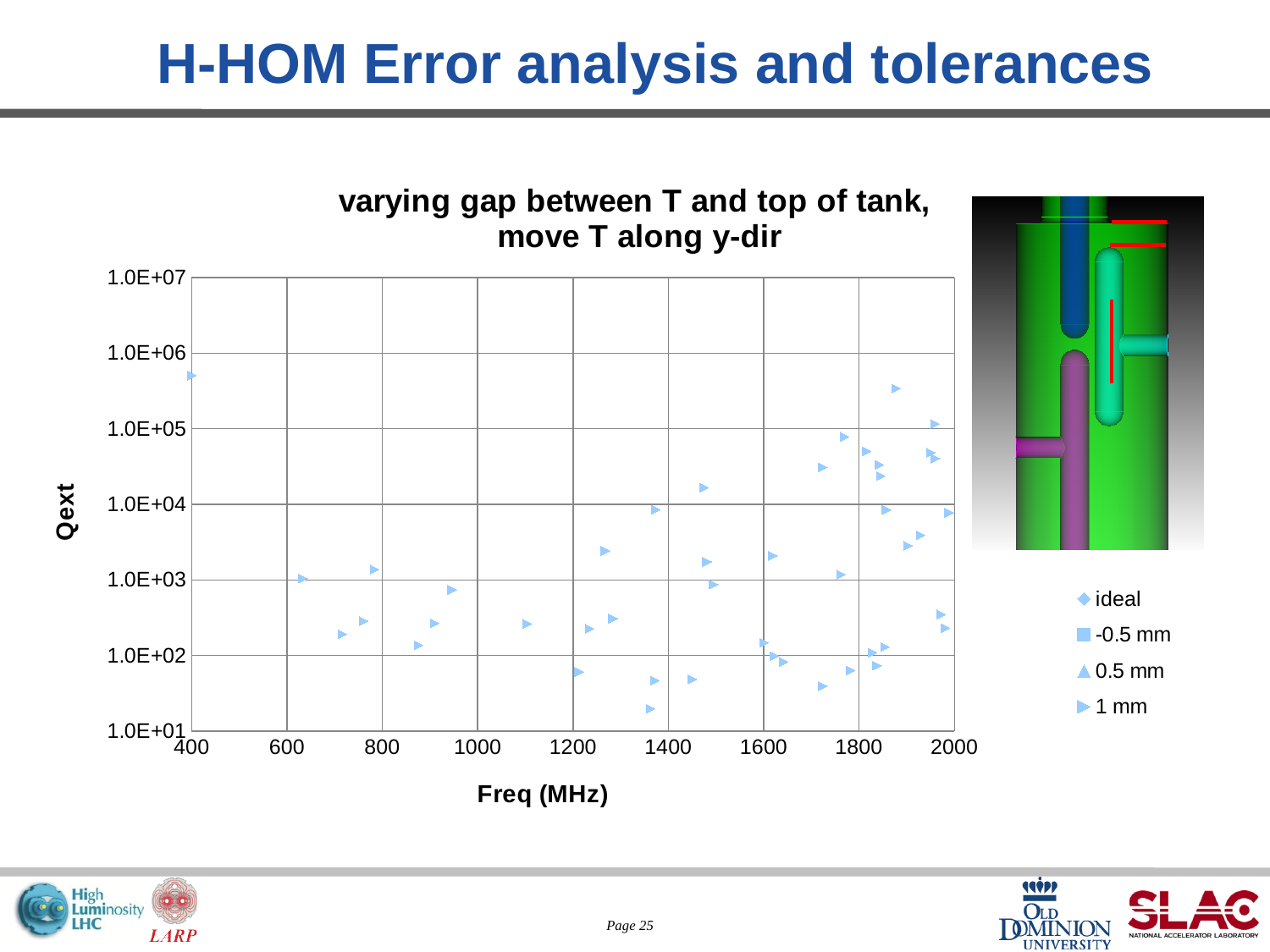
What label is shown on the x axis of the chart? Freq (MHz) How many series does the legend list? 4 Is the lowest plotted Qext value on the chart greater or less than 1.0E+02? less Is the highest plotted Qext value on the chart greater or less than 1.0E+06? less What kind of chart is shown on the slide? scatter chart What is the title of the chart? varying gap between T and top of tank, move T along y-dir